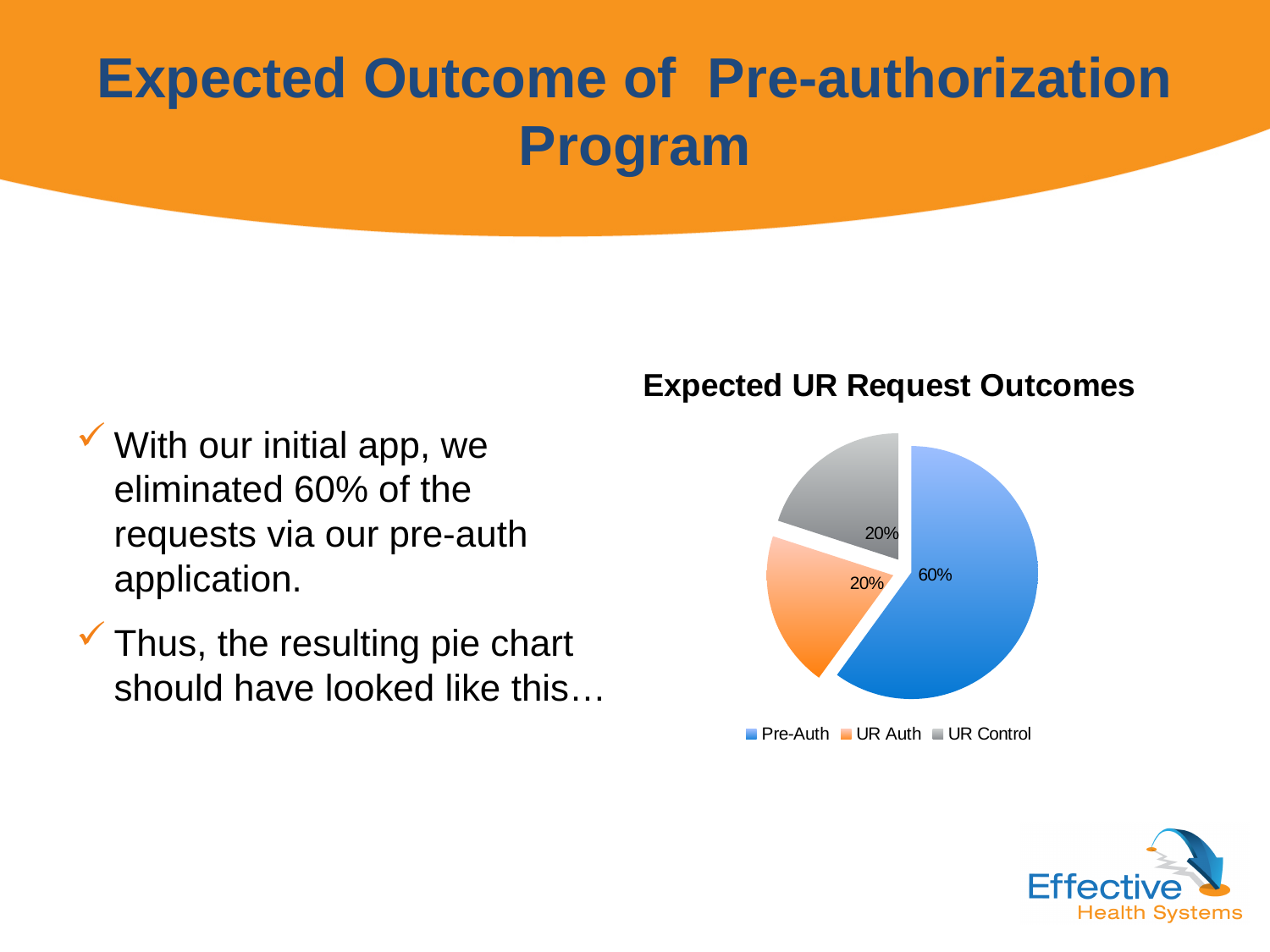
Which is larger, the Pre-Auth slice or the UR Control slice? Pre-Auth What share of the pie does UR Auth represent? 20% What is the difference in percentage points between the Pre-Auth slice and the UR Auth slice? 40% Which category has the largest slice of the pie? Pre-Auth How many slices does the pie chart have? 3 What share of the pie does Pre-Auth represent? 60% What is the title of the pie chart? Expected UR Request Outcomes What kind of chart is shown on the slide? pie chart How many entries does the legend list? 3 What share of the pie does UR Control represent? 20% What colour is the Pre-Auth slice? blue What is the combined share of UR Auth and UR Control? 40%